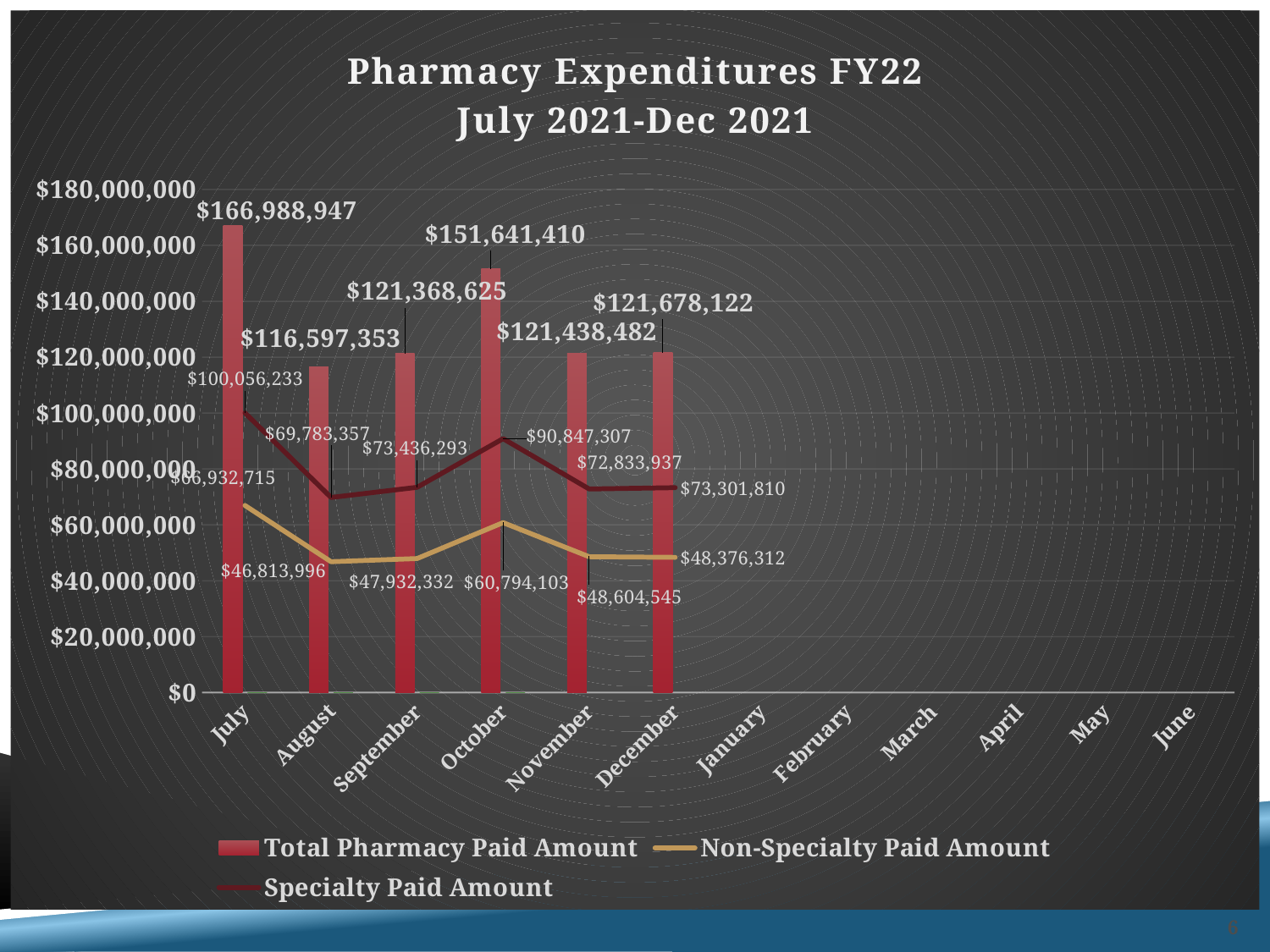
Which month has the lowest Total Pharmacy Paid Amount among the months with data? August How many series does the legend list? 3 Which is larger in October, the Specialty Paid Amount or the Non-Specialty Paid Amount? Specialty Paid Amount Is the Total Pharmacy Paid Amount for October greater or less than $140,000,000? greater What is the difference between the Total Pharmacy Paid Amount for July and for October? $15,347,537 Which month has the lowest Specialty Paid Amount among the months with data? August What is the Non-Specialty Paid Amount for October? $60,794,103 Does the Total Pharmacy Paid Amount rise or fall from July to August? fall How many months have a Total Pharmacy Paid Amount bar plotted? 6 Which month has the highest Total Pharmacy Paid Amount? July What is the Specialty Paid Amount for October? $90,847,307 What is the Total Pharmacy Paid Amount for July? $166,988,947